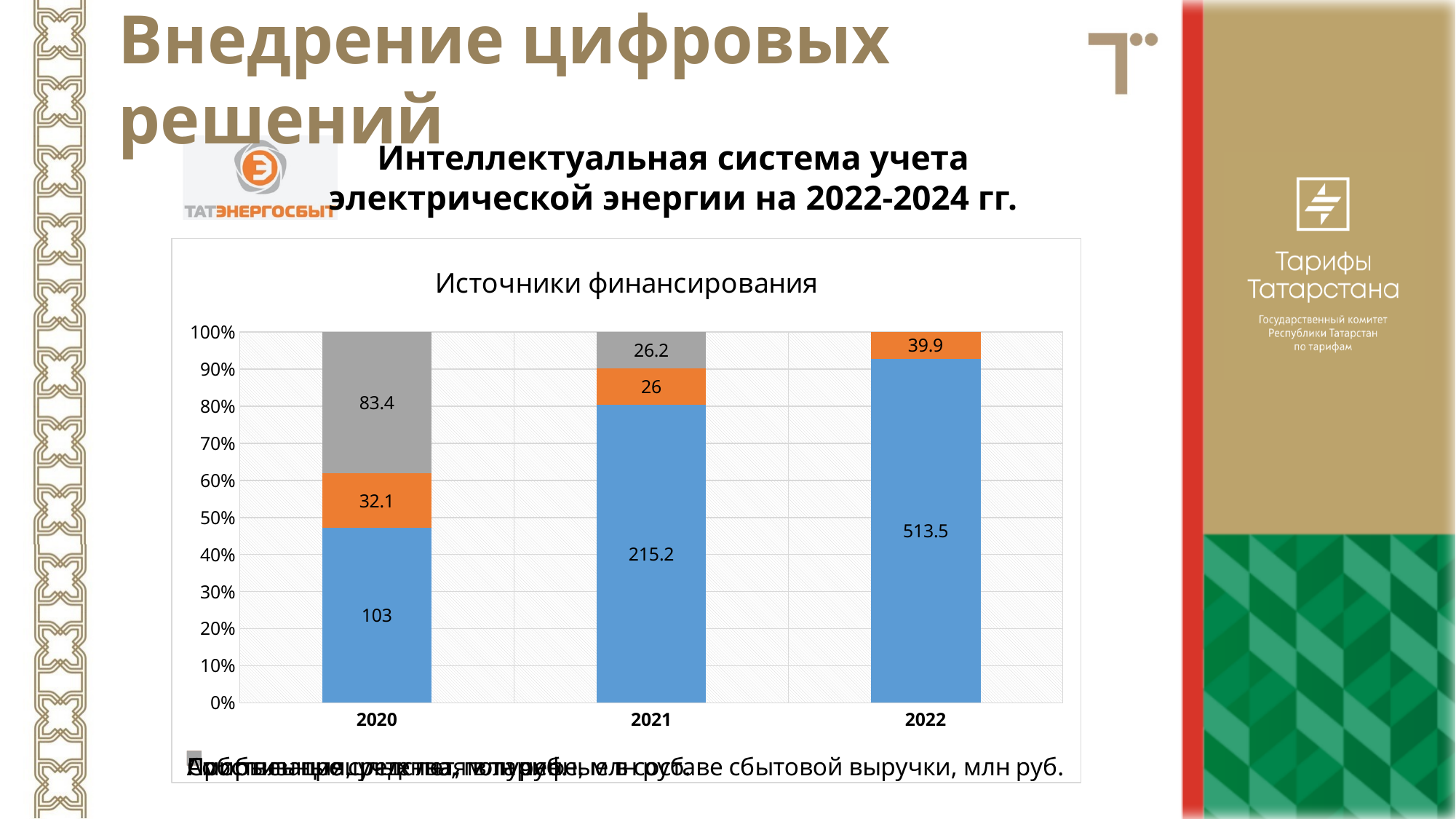
In the chart 'Источники финансирования', which year has the larger orange segment value, 2020 or 2021? 2020 How many years are shown on the x axis of the chart 'Источники финансирования'? 3 In the chart 'Источники финансирования', which year has the largest value for the blue segment? 2022 In the chart 'Источники финансирования', what is the total of all segments for 2022? 553.4 In the chart 'Источники финансирования', what is the value of the blue segment for 2020? 103 In the chart 'Источники финансирования', what is the value of the orange segment for 2022? 39.9 In the chart 'Источники финансирования', do the blue segment values rise or fall from 2020 to 2022? Rise What kind of chart is 'Источники финансирования'? Stacked bar chart In the chart 'Источники финансирования', what is the value of the gray segment for 2021? 26.2 In the chart 'Источники финансирования', what is the total of all segments for 2020? 218.5 In the chart 'Источники финансирования', what is the difference between the blue segment values for 2022 and 2021? 298.3 In the chart 'Источники финансирования', is the share of the blue segment in 2022 greater or less than 80%? greater